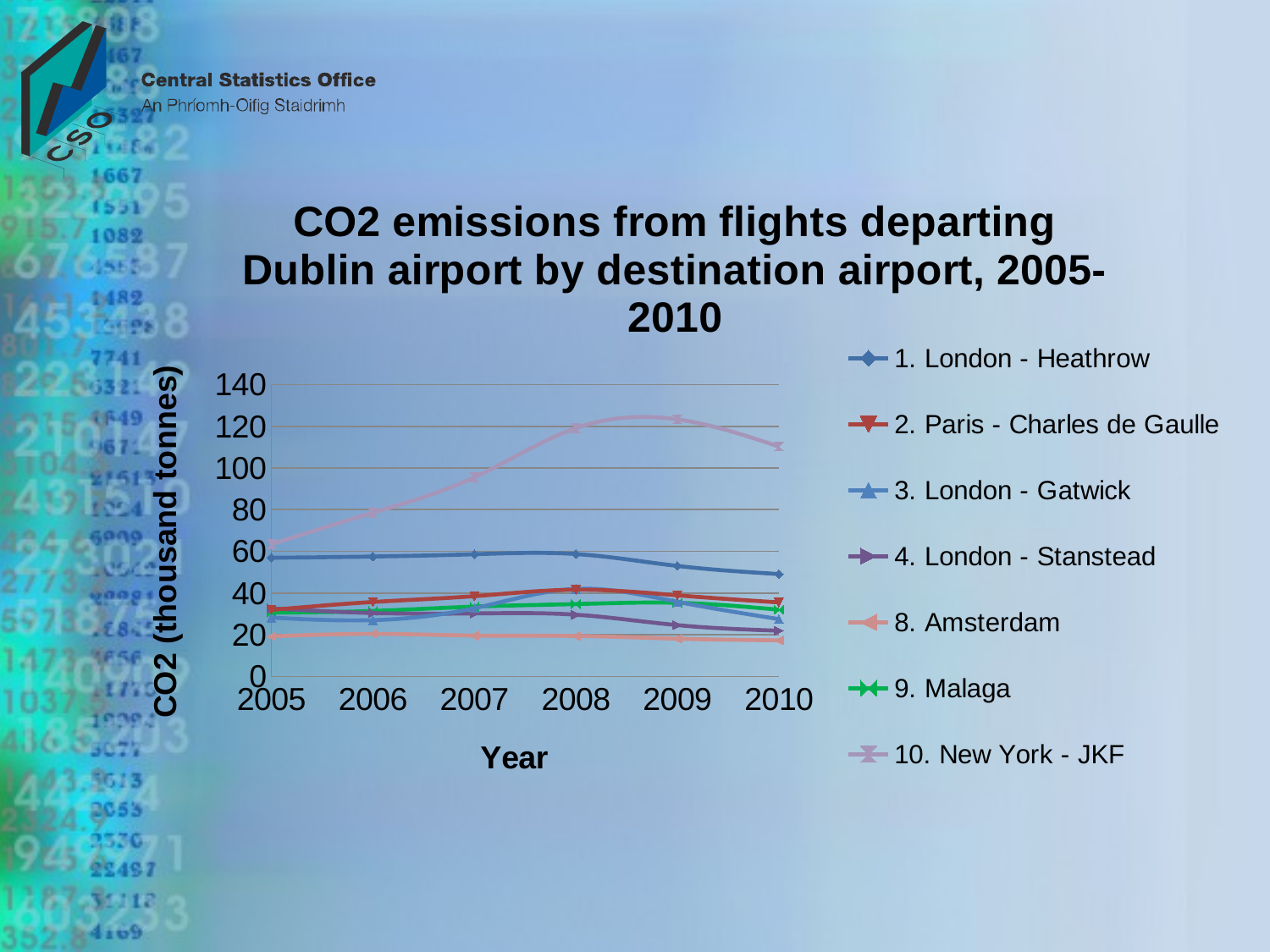
How many destination airports (series) does the legend list? 7 Which destination airport has the lowest CO2 emissions in 2010? 8. Amsterdam In 2005, which has higher CO2 emissions: London - Heathrow or Paris - Charles de Gaulle? 1. London - Heathrow Is the value for Amsterdam in 2005 greater or less than 40? less Do the CO2 emissions for London - Heathrow rise or fall from 2008 to 2010? fall Is the value for New York - JKF in 2005 greater or less than 80? less Which destination airport has the highest CO2 emissions in 2010? 10. New York - JKF Do the CO2 emissions for New York - JKF rise or fall from 2005 to 2009? rise How many years are plotted along the x axis? 6 What kind of chart is shown on the slide? line chart Is the value for London - Heathrow in 2010 greater or less than 60? less